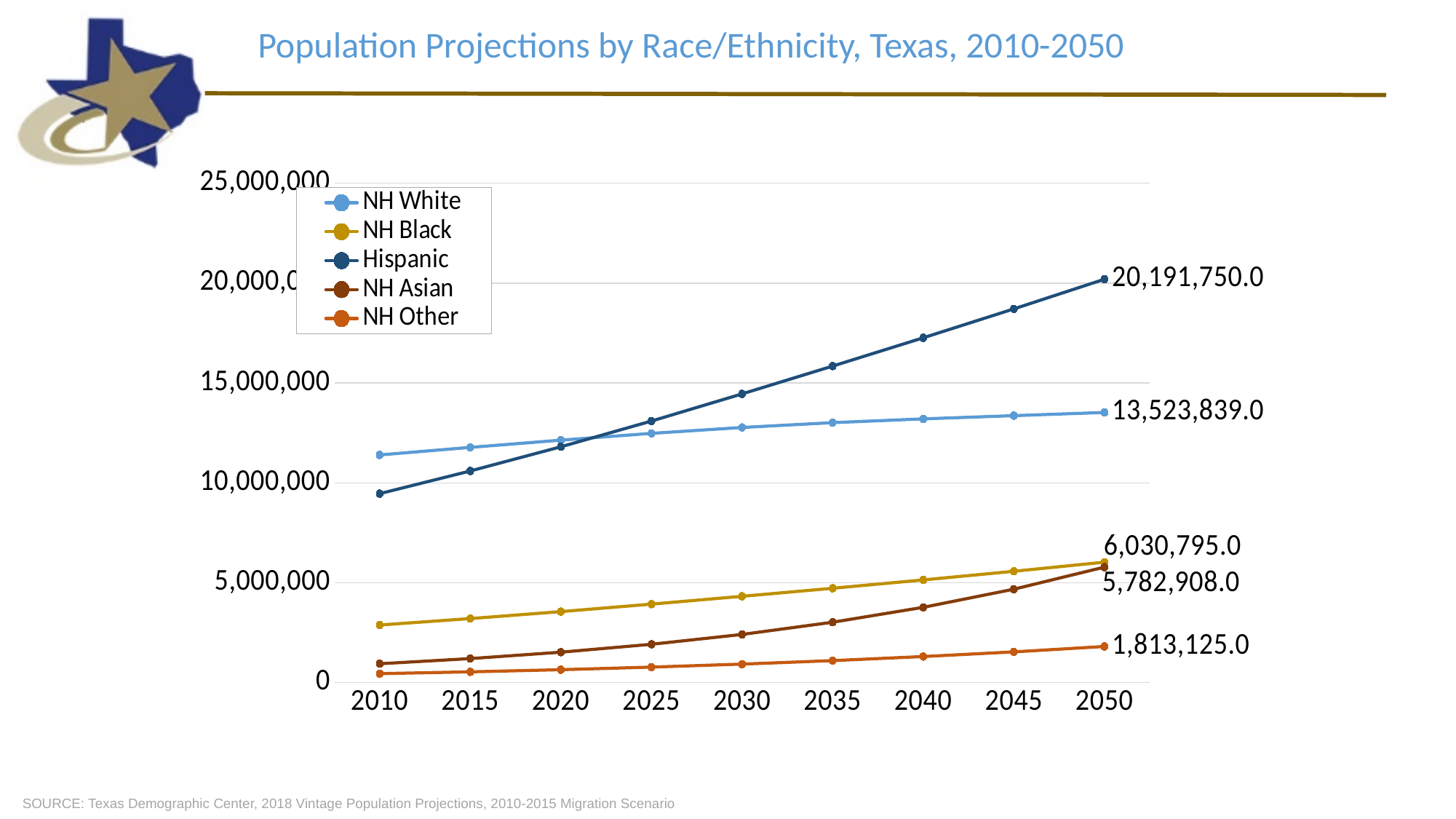
How many years are shown along the x axis? 9 What is the projected Hispanic population in 2050? 20,191,750.0 Is the Hispanic value for 2010 greater or less than 10,000,000? less What kind of chart is shown on the slide? line chart Which series has the highest value in 2050? Hispanic Does the Hispanic series rise or fall from 2010 to 2050? rise What is the projected NH White population in 2050? 13,523,839.0 Which series has the lowest value in 2050? NH Other How many series does the legend list? 5 What is the projected NH Black population in 2050? 6,030,795.0 What is the difference between the Hispanic and NH White values in 2050? 6,667,911.0 What is the projected NH Other population in 2050? 1,813,125.0